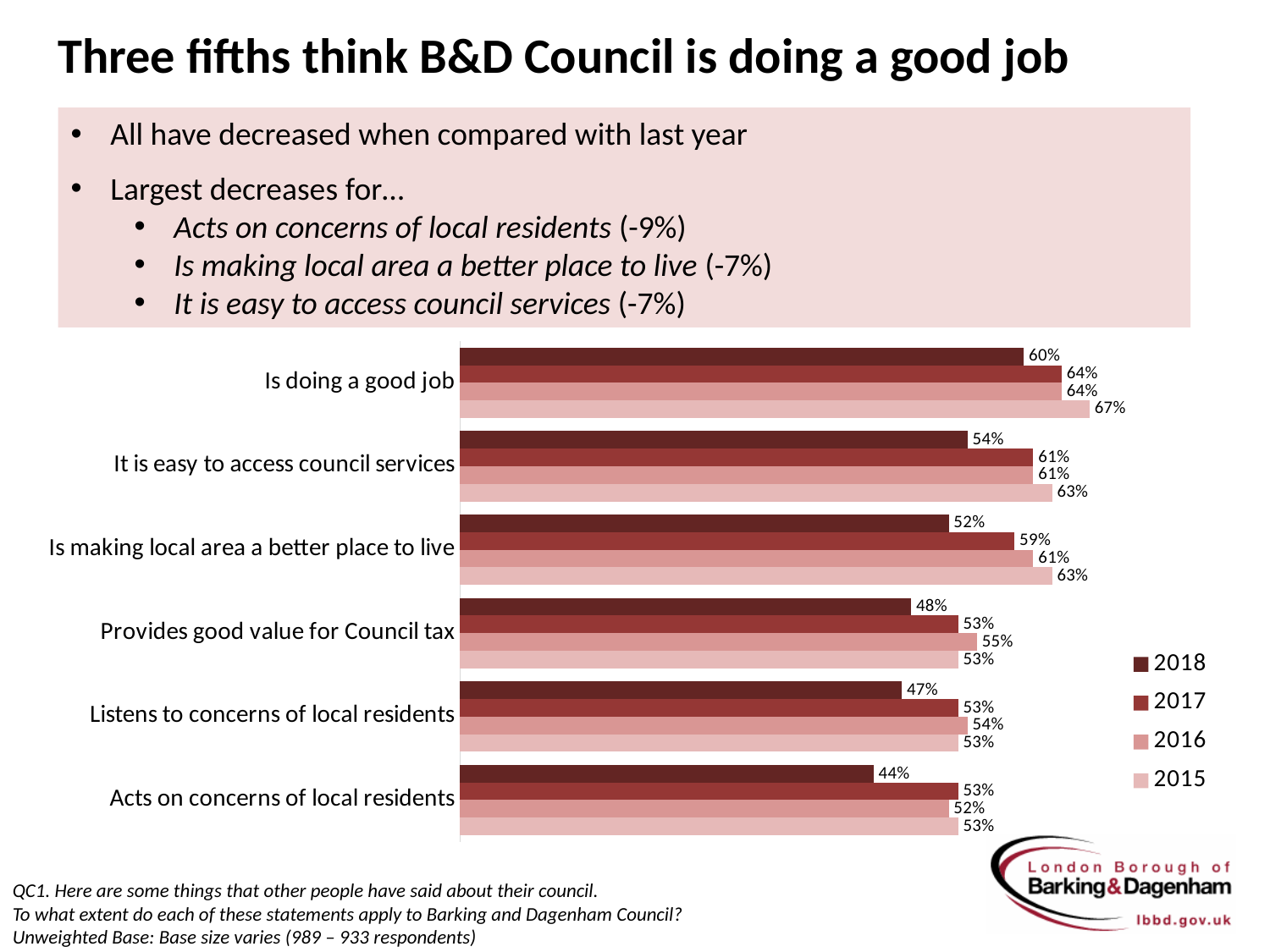
How many series does the legend list? 4 What is the 2017 value for "Is making local area a better place to live"? 59% What is the difference between the 2017 and 2018 values for "Acts on concerns of local residents"? 9% Which is larger for "Provides good value for Council tax": the 2016 value or the 2018 value? 2016 What is the 2018 value for "Acts on concerns of local residents"? 44% Which year does the darkest bar colour represent in the legend? 2018 How many categories are shown on the chart? 6 What is the 2015 value for "Is doing a good job"? 67% Which category has the lowest 2018 value? Acts on concerns of local residents Which category has the highest 2015 value? Is doing a good job What is the 2018 value for "Is doing a good job"? 60% What kind of chart is shown on the slide? Bar chart